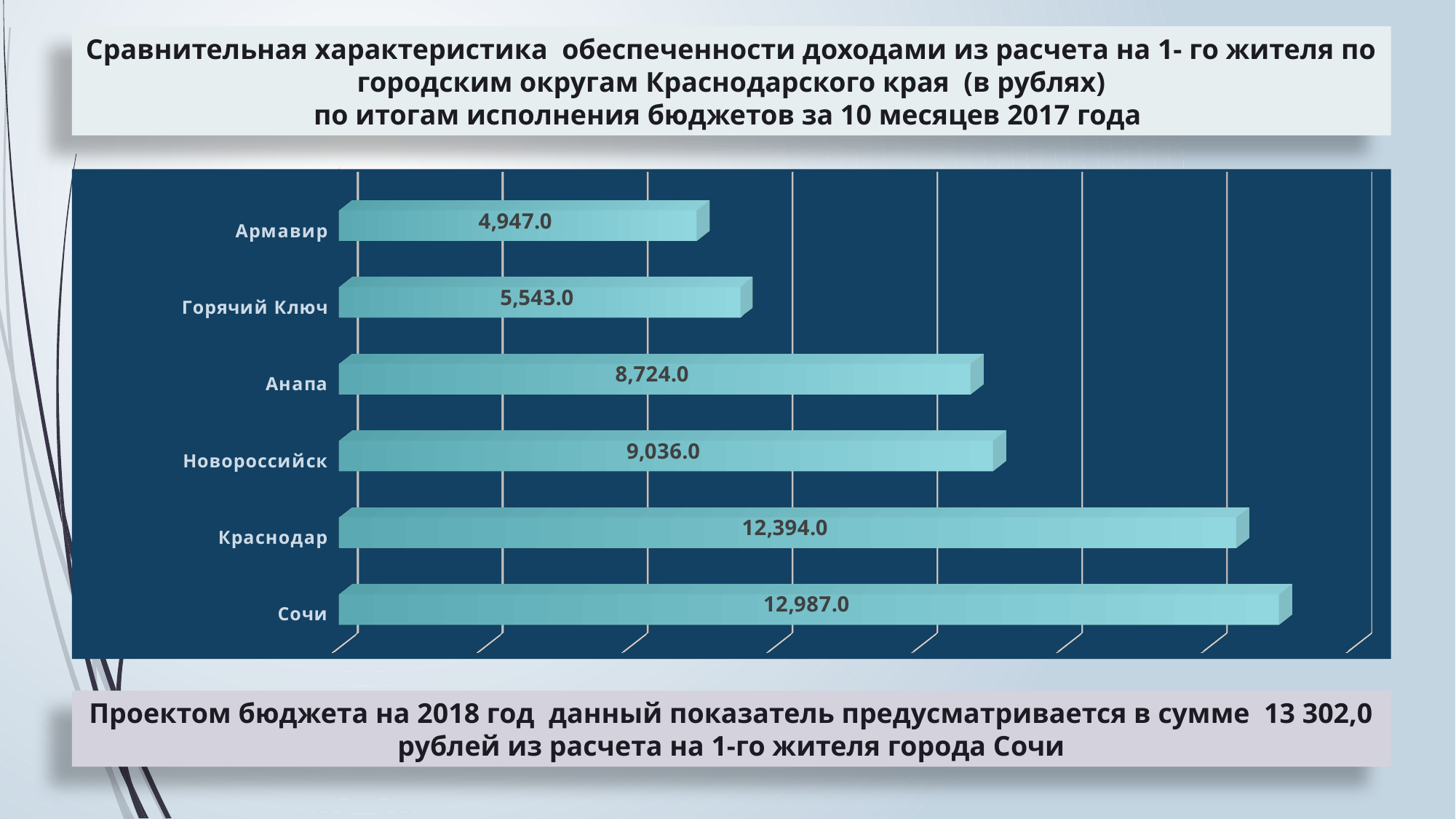
Which city has the lowest value? Армавир How many cities are shown in the chart? 6 What is the value for Горячий Ключ? 5,543.0 Which is larger, the value for Краснодар or the value for Новороссийск? Краснодар What is the value for Новороссийск? 9,036.0 According to the text below the chart, what value is planned for Сочи in the 2018 budget? 13 302,0 What is the difference between the values for Сочи and Краснодар? 593.0 What is the difference between the values for Новороссийск and Анапа? 312.0 What is the value for Анапа? 8,724.0 Which city has the highest value? Сочи What is the value for Сочи? 12,987.0 What kind of chart is shown on the slide? Bar chart